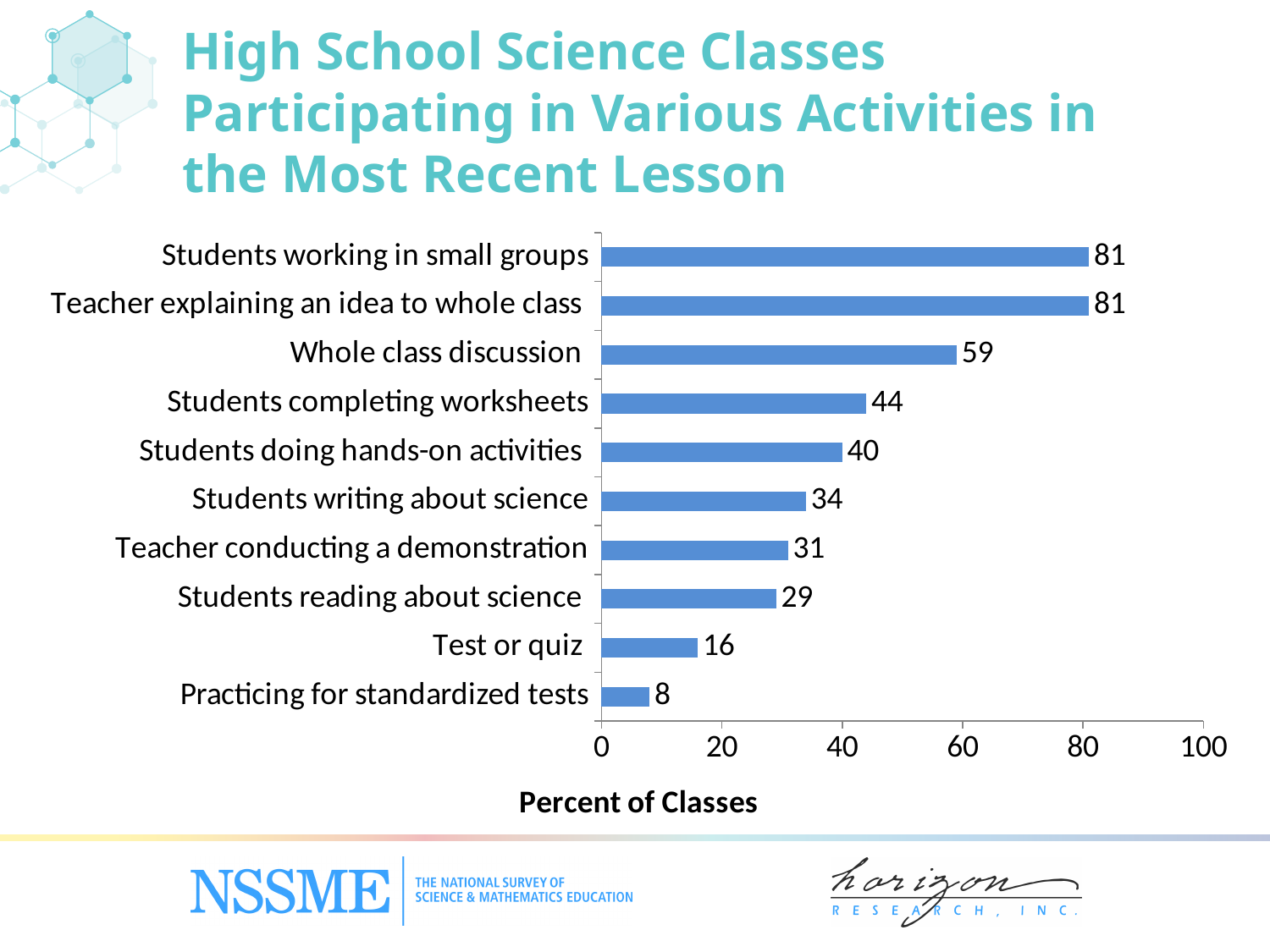
What kind of chart is shown on the slide? Bar chart What is the difference between Students completing worksheets and Students reading about science? 15 How many activities are shown in the chart? 10 What is the label of the horizontal axis? Percent of Classes Which activity has the lowest percent of classes? Practicing for standardized tests What percent of classes had students doing hands-on activities? 40 Which is larger, Students writing about science or Teacher conducting a demonstration? Students writing about science What is the value for Practicing for standardized tests? 8 What is the value for Whole class discussion? 59 Is the value for Students completing worksheets greater or less than 40? greater What percent of classes had students working in small groups? 81 What is the difference between Whole class discussion and Test or quiz? 43